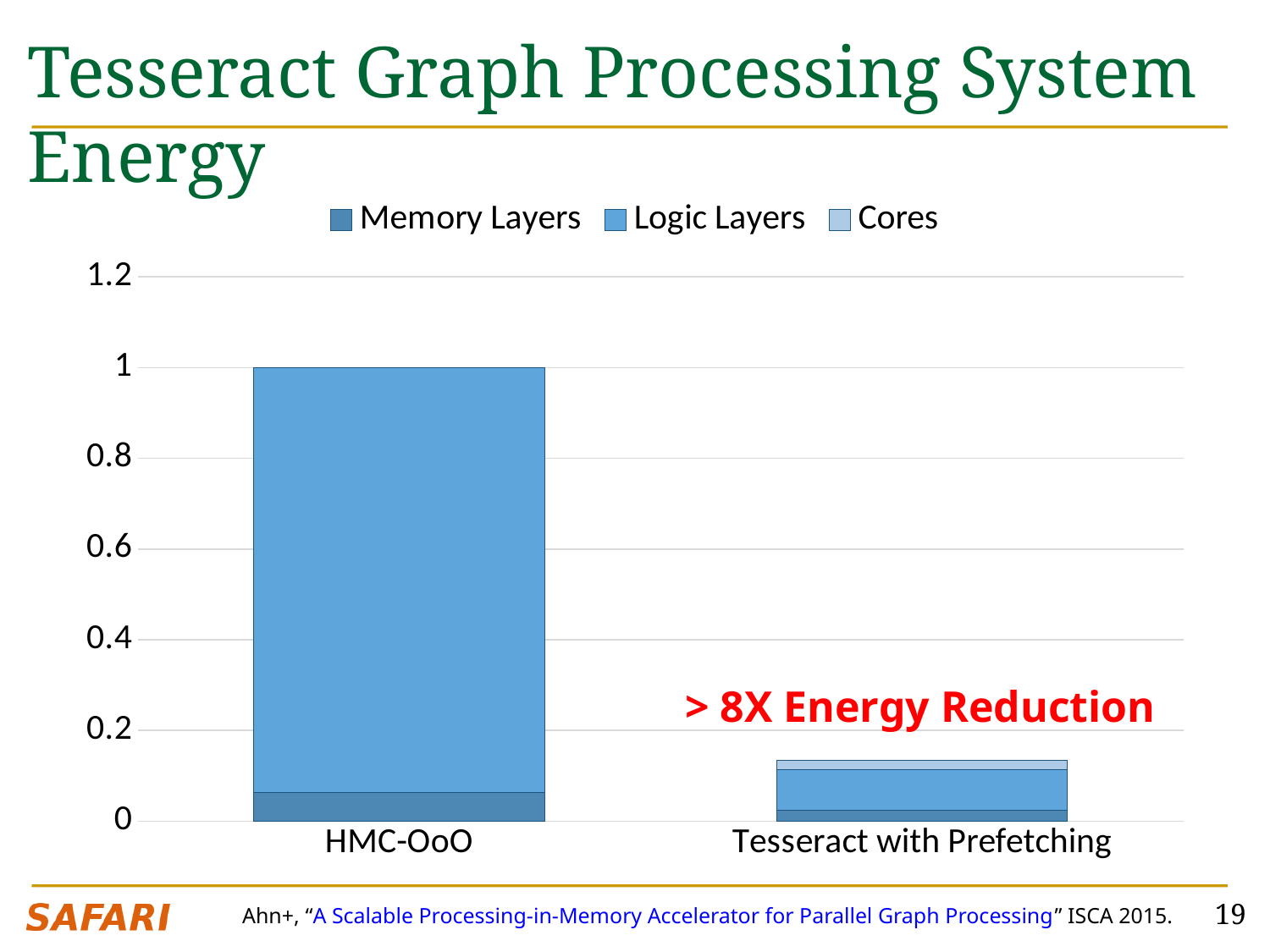
What are the three series listed in the chart legend? Memory Layers, Logic Layers, Cores How many series does the chart legend list? 3 Which has a larger total energy, HMC-OoO or Tesseract with Prefetching? HMC-OoO Which category has the highest total energy in the chart? HMC-OoO What is the total height of the HMC-OoO stacked bar? 1 What kind of chart is shown on the slide? stacked bar chart How many categories are shown on the x axis of the chart? 2 What does the red annotation on the chart say? > 8X Energy Reduction Is the total value for HMC-OoO greater or less than 0.8? greater Is the total value for Tesseract with Prefetching greater or less than 0.2? less Which category has the lowest total energy in the chart? Tesseract with Prefetching Which series makes up the largest portion of the HMC-OoO bar? Logic Layers